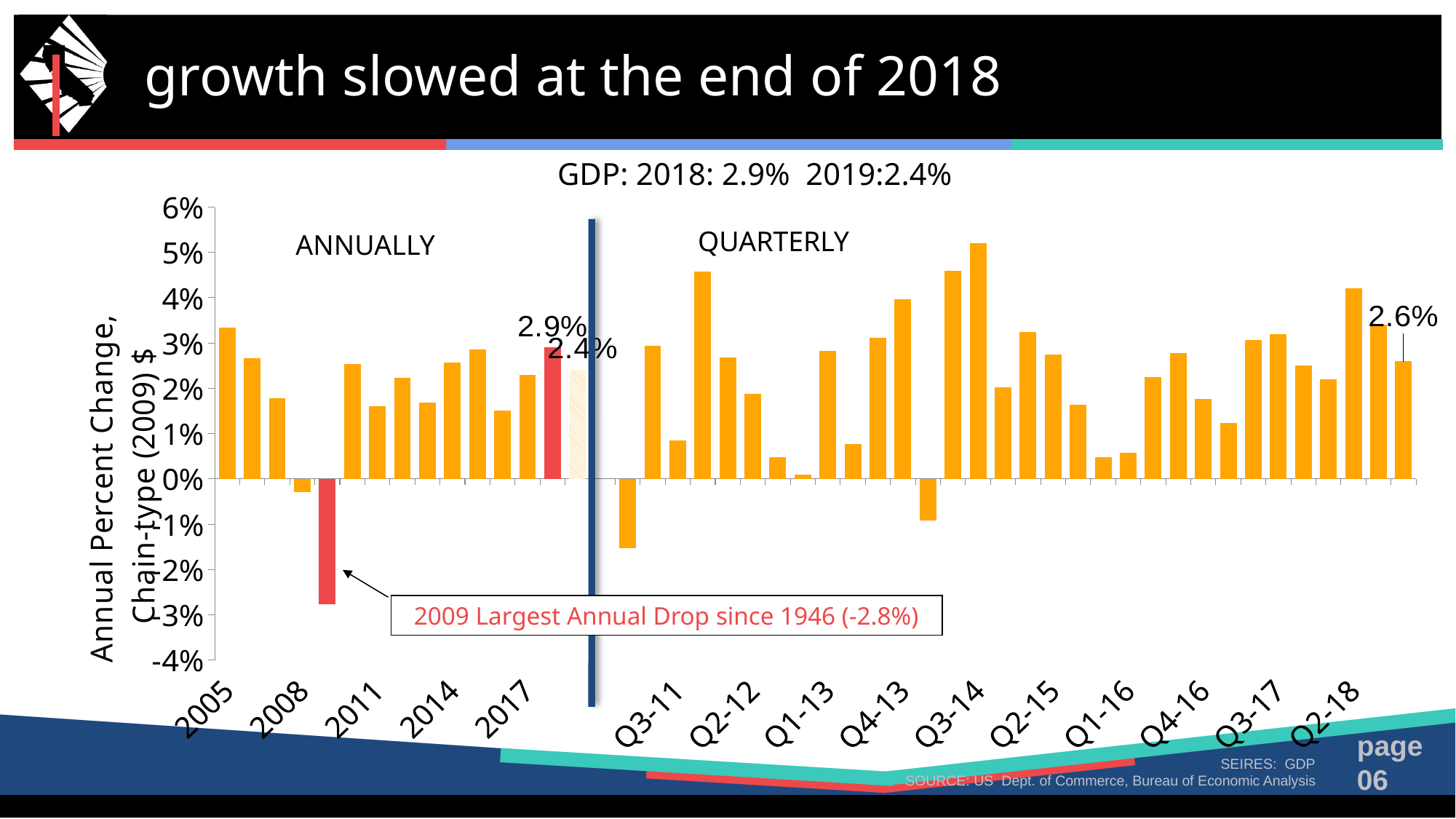
What is the title of the vertical axis? Annual Percent Change, Chain-type (2009) $ What is the annual GDP growth value labeled for 2018? 2.9% What is the annual GDP growth value labeled for 2019? 2.4% What value does the annotation give for the 2009 annual drop? -2.8% Which is larger, the annual value for 2018 or for 2019? 2018 What value is labeled on the last bar in the QUARTERLY section? 2.6% What kind of chart is shown on the slide? bar chart What is the difference between the annual values for 2018 and 2019? 0.5% Is the annual value for 2008 greater or less than 0%? less How many annual bars are shown in the ANNUALLY section? 15 Which year in the ANNUALLY section has the lowest value? 2009 Is the annual value for 2005 greater or less than 3%? greater